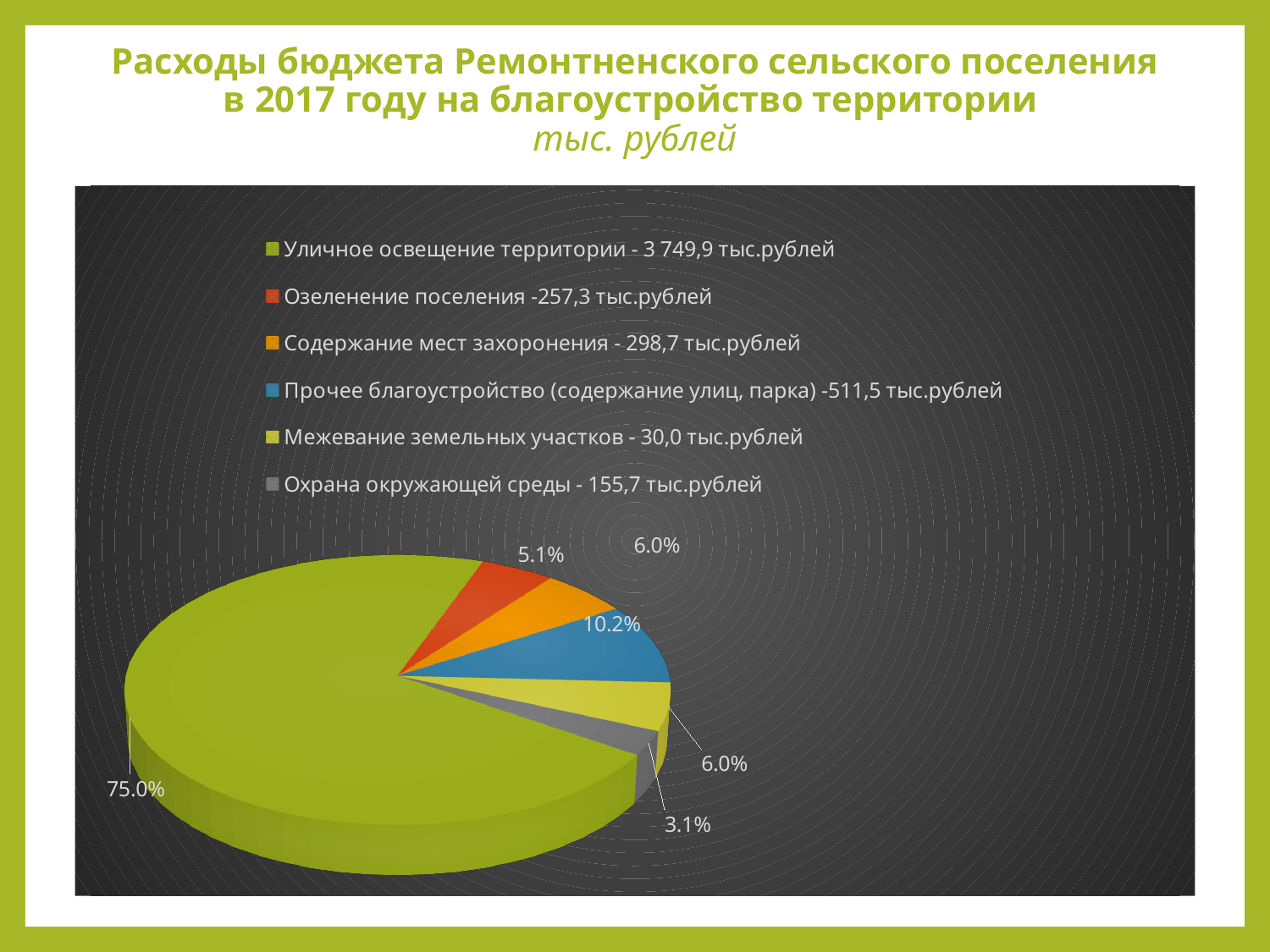
According to the legend, how much was spent on Охрана окружающей среды? 155,7 тыс.рублей According to the legend, how much was spent on Озеленение поселения? 257,3 тыс.рублей What share of the pie does Уличное освещение территории take? 75.0% What is the difference between the expenditure on Прочее благоустройство (содержание улиц, парка) and on Содержание мест захоронения, in тыс.рублей? 212,8 Which is larger: the expenditure on Озеленение поселения or on Содержание мест захоронения? Содержание мест захоронения Which category has the largest expenditure? Уличное освещение территории How many categories does the pie chart show? 6 Which category has the smallest expenditure? Межевание земельных участков What type of chart is shown on the slide? pie chart According to the legend, how much was spent on Уличное освещение территории? 3 749,9 тыс.рублей According to the legend, how much was spent on Прочее благоустройство (содержание улиц, парка)? 511,5 тыс.рублей What share of the pie does Прочее благоустройство (содержание улиц, парка) take? 10.2%